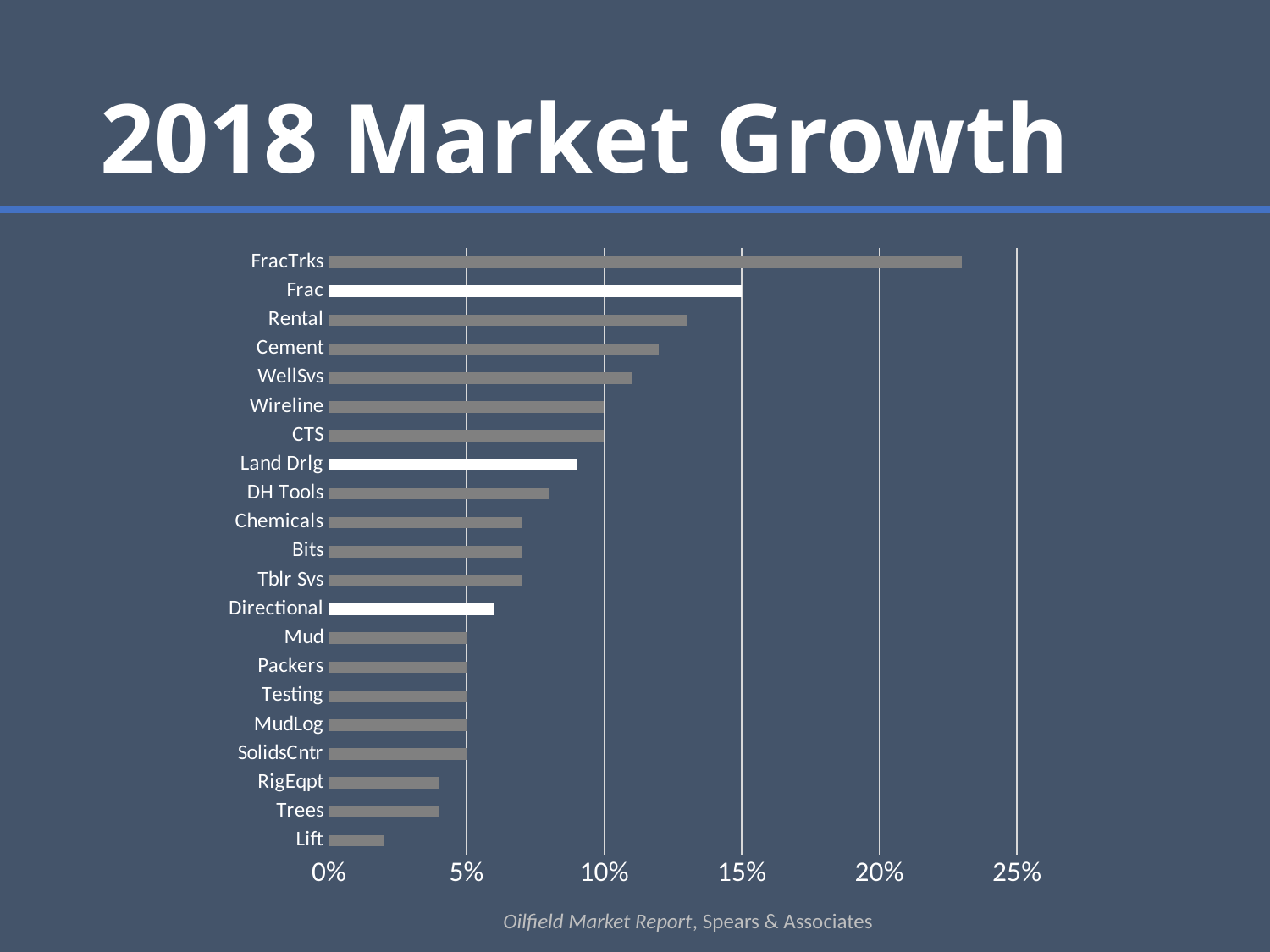
What is the value for Frac? 15% How many categories are plotted in the chart? 21 Is the value for Rental greater or less than 10%? greater What kind of chart is shown on the slide? bar chart Which category has the lowest market growth? Lift Is the value for Lift greater or less than 5%? less What is the value for Wireline? 10% Which categories are drawn with white bars instead of grey? Frac, Land Drlg, Directional What is the title of the slide? 2018 Market Growth Which category has the highest market growth? FracTrks Which is larger, the value for Rental or the value for Land Drlg? Rental Is the value for FracTrks greater or less than 20%? greater